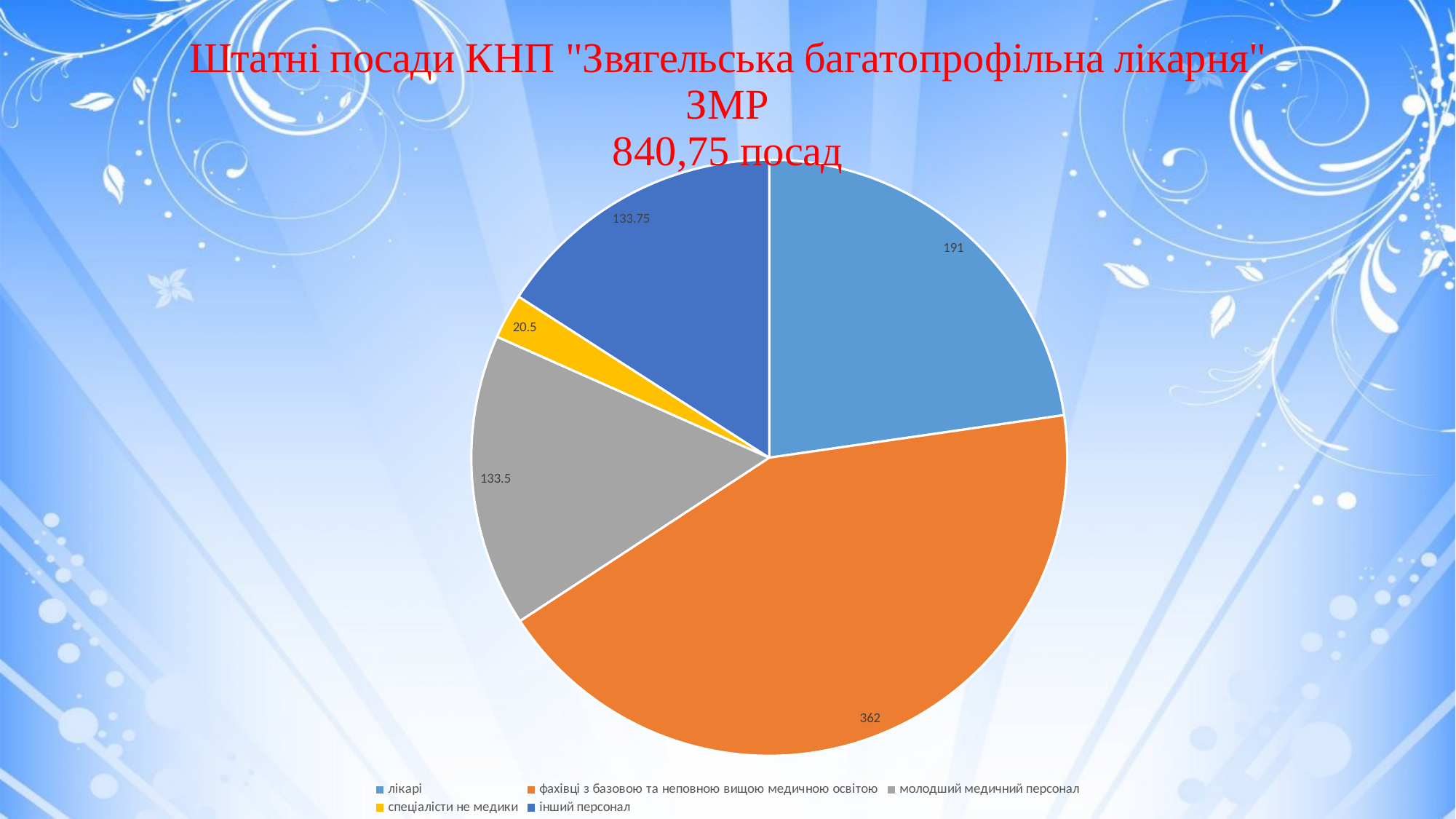
What is the value for інший персонал? 133.75 Which category has the largest slice? фахівці з базовою та неповною вищою медичною освітою What is the value for лікарі? 191 How many entries does the legend list? 5 How many slices does the pie chart have? 5 Which category has the smallest slice? спеціалісти не медики What is the value for молодший медичний персонал? 133.5 What type of chart is shown on the slide? pie chart Which is larger, the value for лікарі or the value for молодший медичний персонал? лікарі What is the value for спеціалісти не медики? 20.5 What is the difference between the values for фахівці з базовою та неповною вищою медичною освітою and лікарі? 171 What is the value for фахівці з базовою та неповною вищою медичною освітою? 362